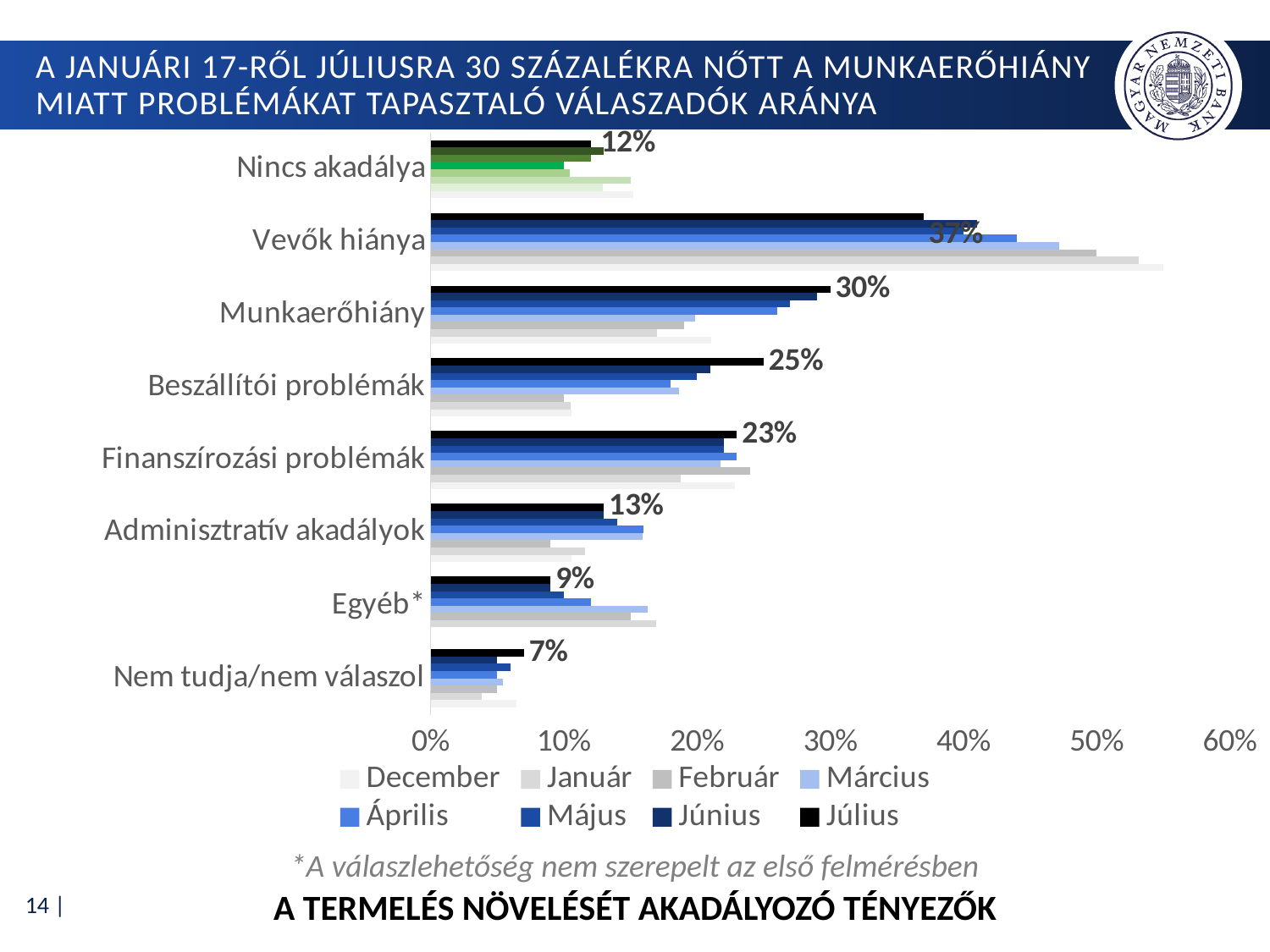
Which has the larger Július value, Finanszírozási problémák or Adminisztratív akadályok? Finanszírozási problémák How many series does the legend list? 8 How many categories are shown on the chart? 8 What is the Július value for Beszállítói problémák? 25% What is the Július value for Vevők hiánya? 37% Which category has the lowest Július value? Nem tudja/nem válaszol What kind of chart is shown on the slide? bar chart Is the December value for Vevők hiánya greater or less than 50%? greater What is the Július value for Munkaerőhiány? 30% What is the Július value for Nem tudja/nem válaszol? 7% Which category has the highest Július value? Vevők hiánya What is the difference between the Július values for Vevők hiánya and Munkaerőhiány? 7 percentage points